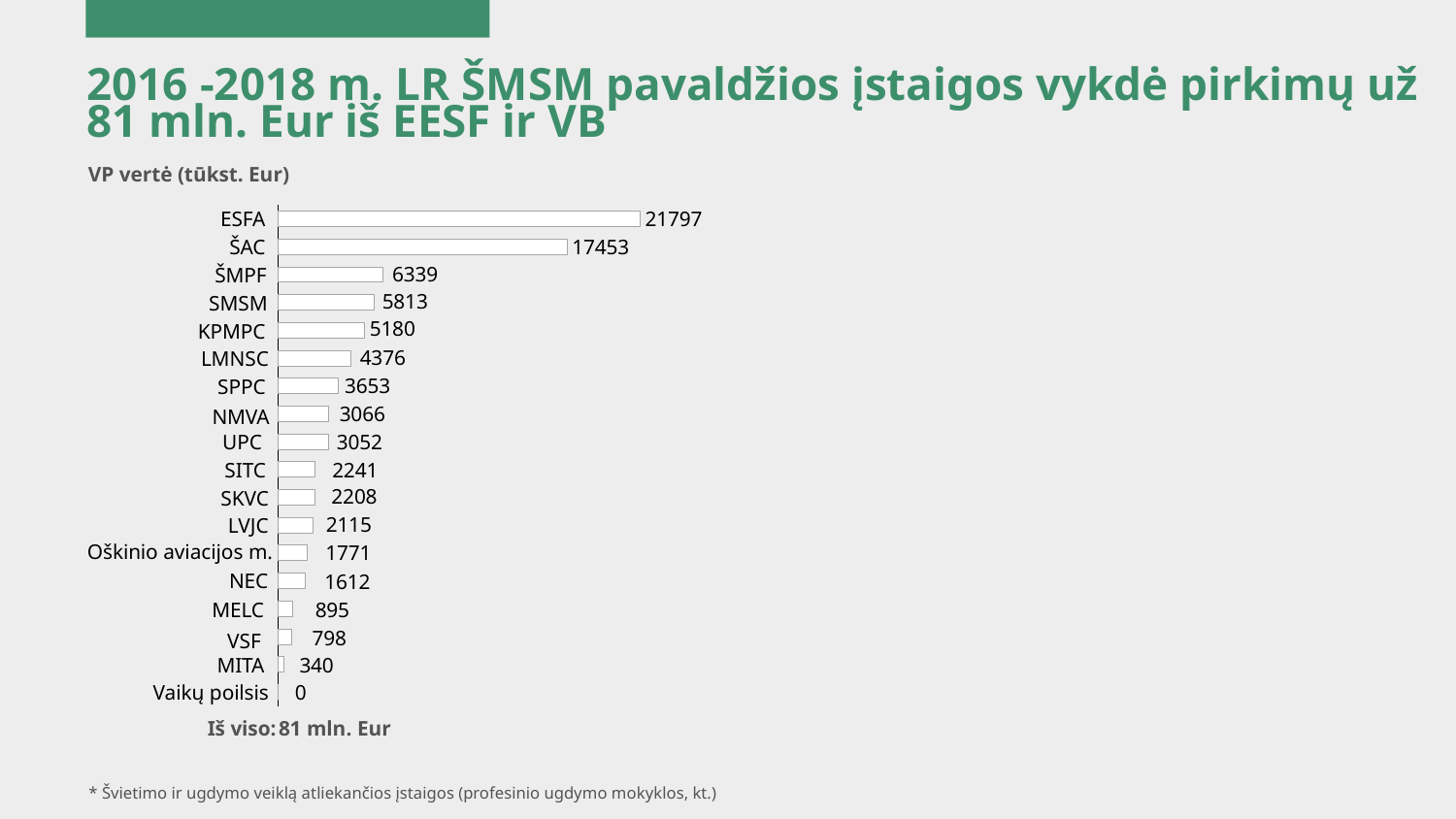
Which category has the highest value? ESFA How many categories are shown in the chart? 18 What is the value for ESFA? 21797 What total is stated below the chart (Iš viso)? 81 mln. Eur What kind of chart is shown on the slide? Bar chart What is the title of the chart? VP vertė (tūkst. Eur) What is the value for Oškinio aviacijos m.? 1771 What is the value for KPMPC? 5180 What is the difference between the values for ESFA and ŠAC? 4344 Which is larger, the value for SMSM or the value for LMNSC? SMSM Which category has the lowest value? Vaikų poilsis What is the value for MITA? 340